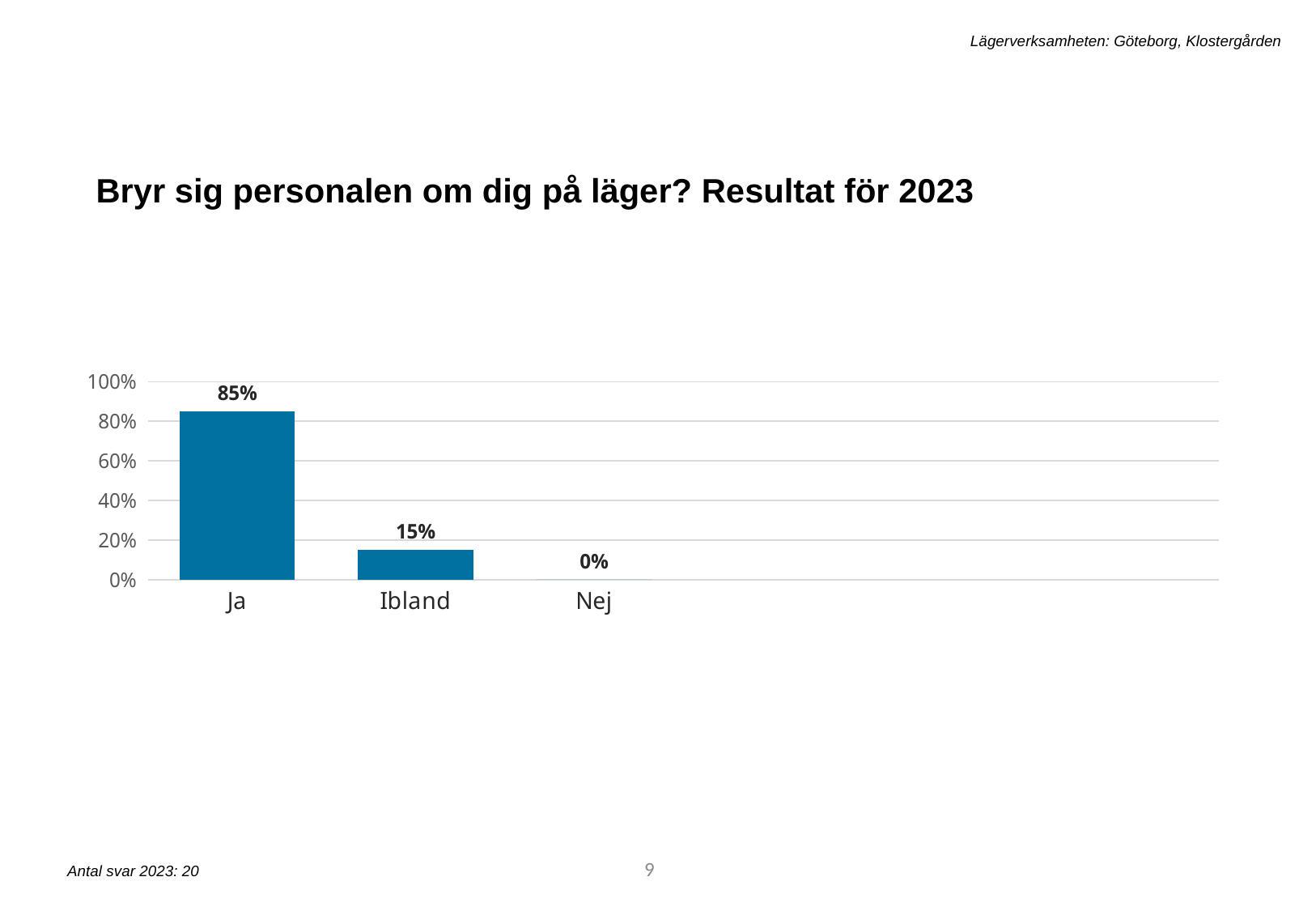
How many categories are shown on the x axis? 3 What is the value for Ibland? 15% Which category has the highest value? Ja Do the values rise or fall from left to right along the x axis? fall Which category has the lowest value? Nej What is the title of the chart on the slide? Bryr sig personalen om dig på läger? Resultat för 2023 What kind of chart is shown on the slide? bar chart Is the value for Ja greater or less than 80%? greater What is the difference between the values for Ja and Ibland? 70% What is the value for Ja? 85% What is the value for Nej? 0% Which is larger, the value for Ibland or the value for Nej? Ibland